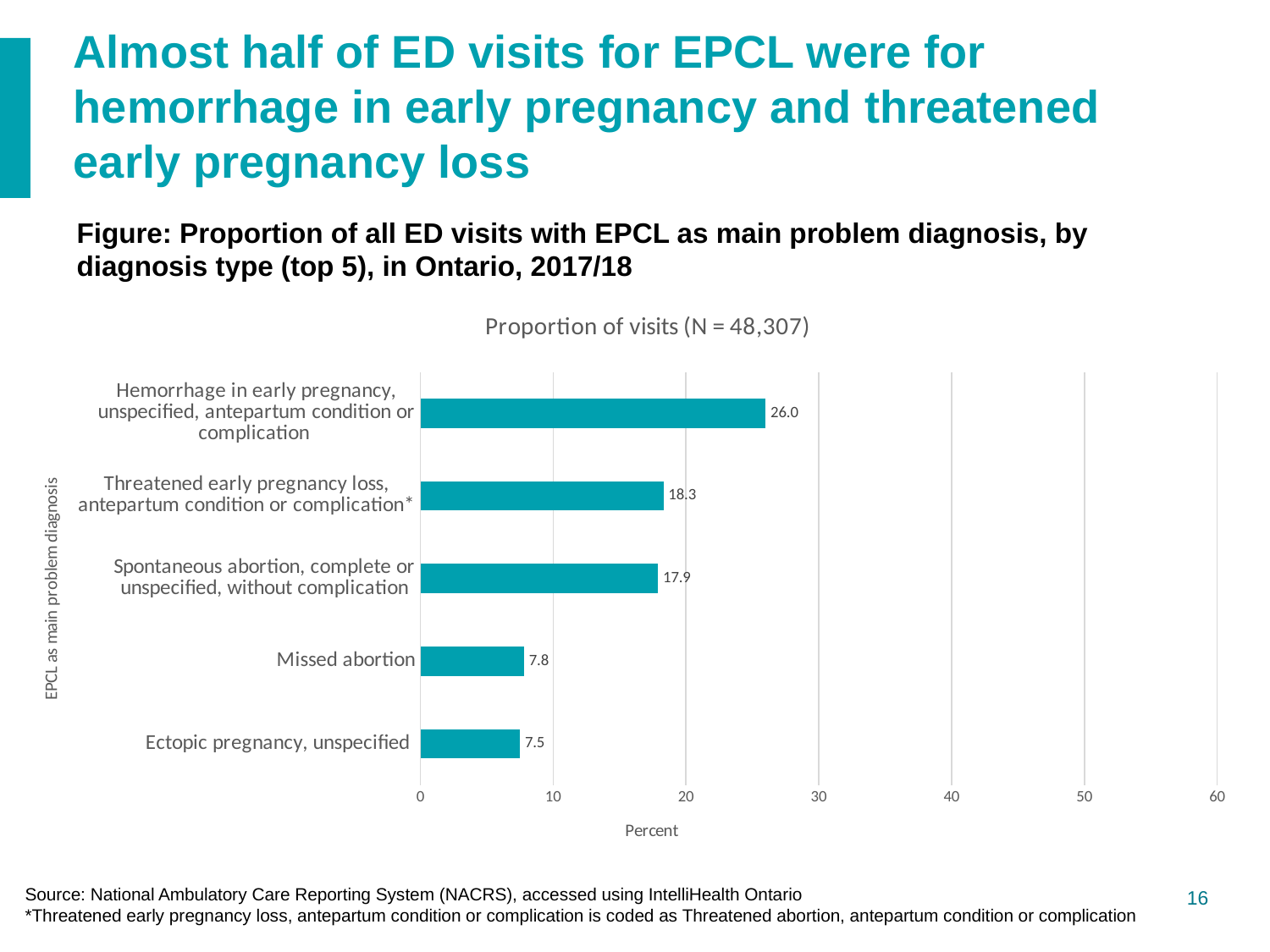
What is the value for Missed abortion? 7.8 Which diagnosis type has the highest proportion of visits? Hemorrhage in early pregnancy, unspecified, antepartum condition or complication What is the title of the chart? Proportion of visits (N = 48,307) What is the difference between the values for Missed abortion and Ectopic pregnancy, unspecified? 0.3 Which diagnosis type has the lowest proportion of visits? Ectopic pregnancy, unspecified What kind of chart is shown on the slide? bar chart Which is larger: the value for Spontaneous abortion, complete or unspecified, without complication or the value for Missed abortion? Spontaneous abortion, complete or unspecified, without complication What is the difference between the values for Hemorrhage in early pregnancy, unspecified, antepartum condition or complication and Threatened early pregnancy loss, antepartum condition or complication*? 7.7 What is the value for Hemorrhage in early pregnancy, unspecified, antepartum condition or complication? 26.0 How many diagnosis types are shown in the chart? 5 What is the value for Ectopic pregnancy, unspecified? 7.5 Is the value for Threatened early pregnancy loss, antepartum condition or complication* greater or less than 20? less